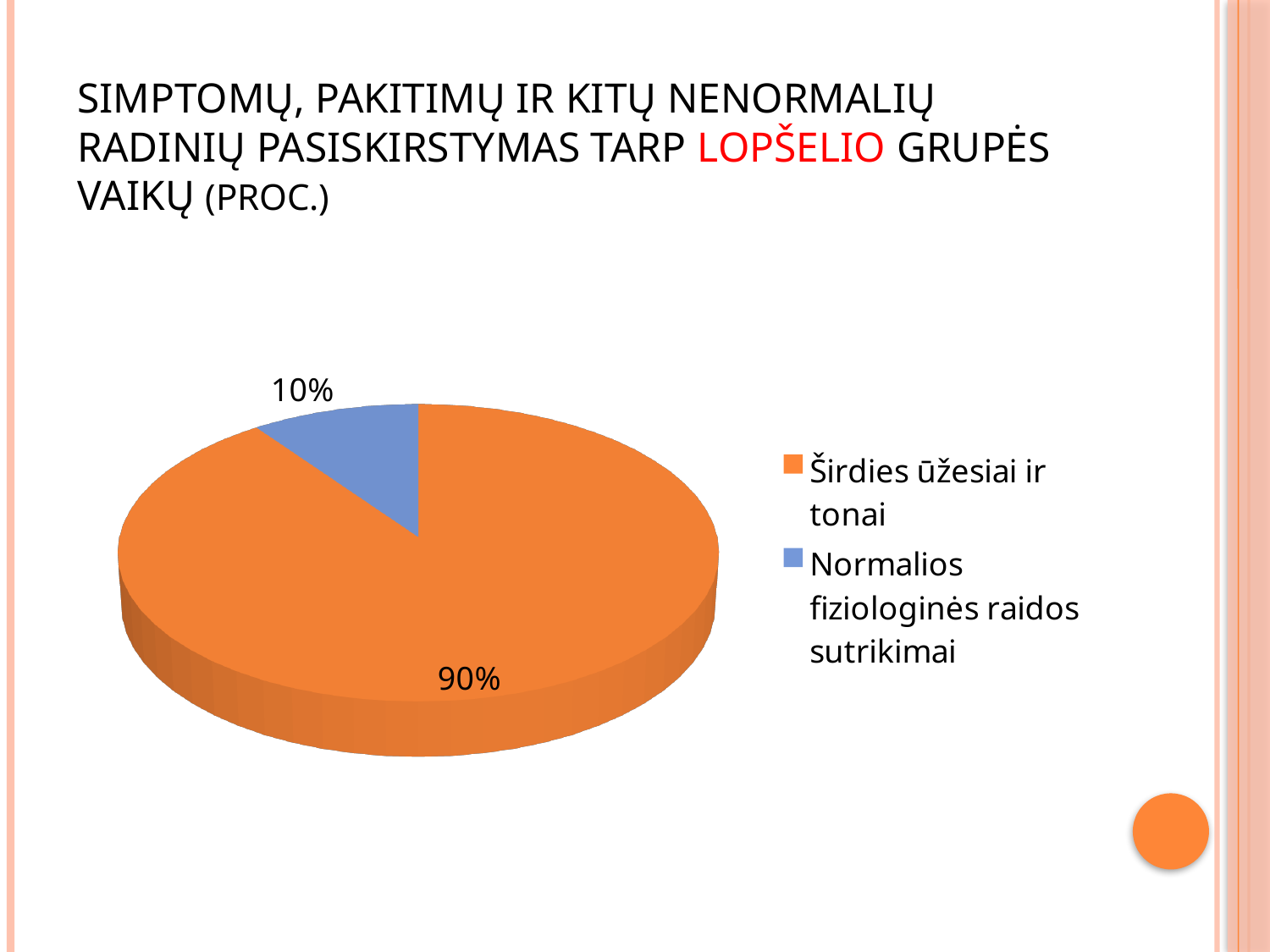
What colour is the slice for "Normalios fiziologinės raidos sutrikimai"? blue How many slices does the pie chart have? 2 What share of the pie does "Normalios fiziologinės raidos sutrikimai" take? 10% Which category has the smallest slice of the pie? Normalios fiziologinės raidos sutrikimai What colour is the slice for "Širdies ūžesiai ir tonai"? orange How many entries does the legend list? 2 Which is larger: the slice for "Širdies ūžesiai ir tonai" or the slice for "Normalios fiziologinės raidos sutrikimai"? Širdies ūžesiai ir tonai What kind of chart is shown on the slide? pie chart Which category has the largest slice of the pie? Širdies ūžesiai ir tonai What share of the pie does "Širdies ūžesiai ir tonai" take? 90% What is the difference in percentage points between the "Širdies ūžesiai ir tonai" slice and the "Normalios fiziologinės raidos sutrikimai" slice? 80